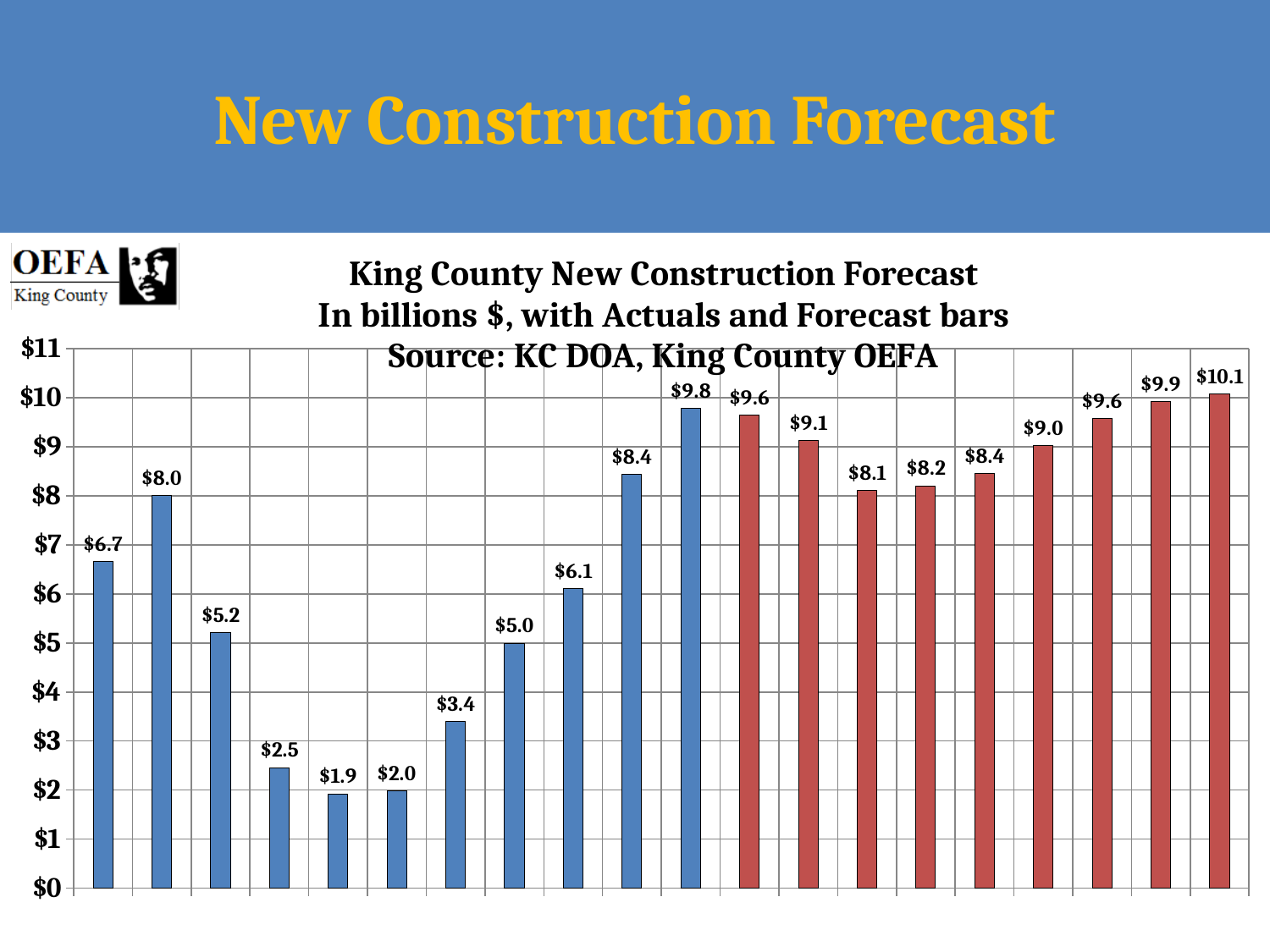
What kind of chart is shown on the slide? bar chart Which is larger, the second bar from the left or the third bar from the left? the second bar ($8.0) What is the value of the lowest bar in the chart? $1.9 What is the value of the last (rightmost) bar? $10.1 What is the value of the first (leftmost) bar? $6.7 What is the value of the tallest blue bar? $9.8 What is the difference between the last blue bar ($9.8) and the first red bar ($9.6)? $0.2 What is the highest value shown in the chart? $10.1 How many red (Forecast) bars are there in the chart? 9 What is the source cited in the chart title? KC DOA, King County OEFA How many bars are plotted in the chart? 20 How many blue (Actuals) bars are there in the chart? 11